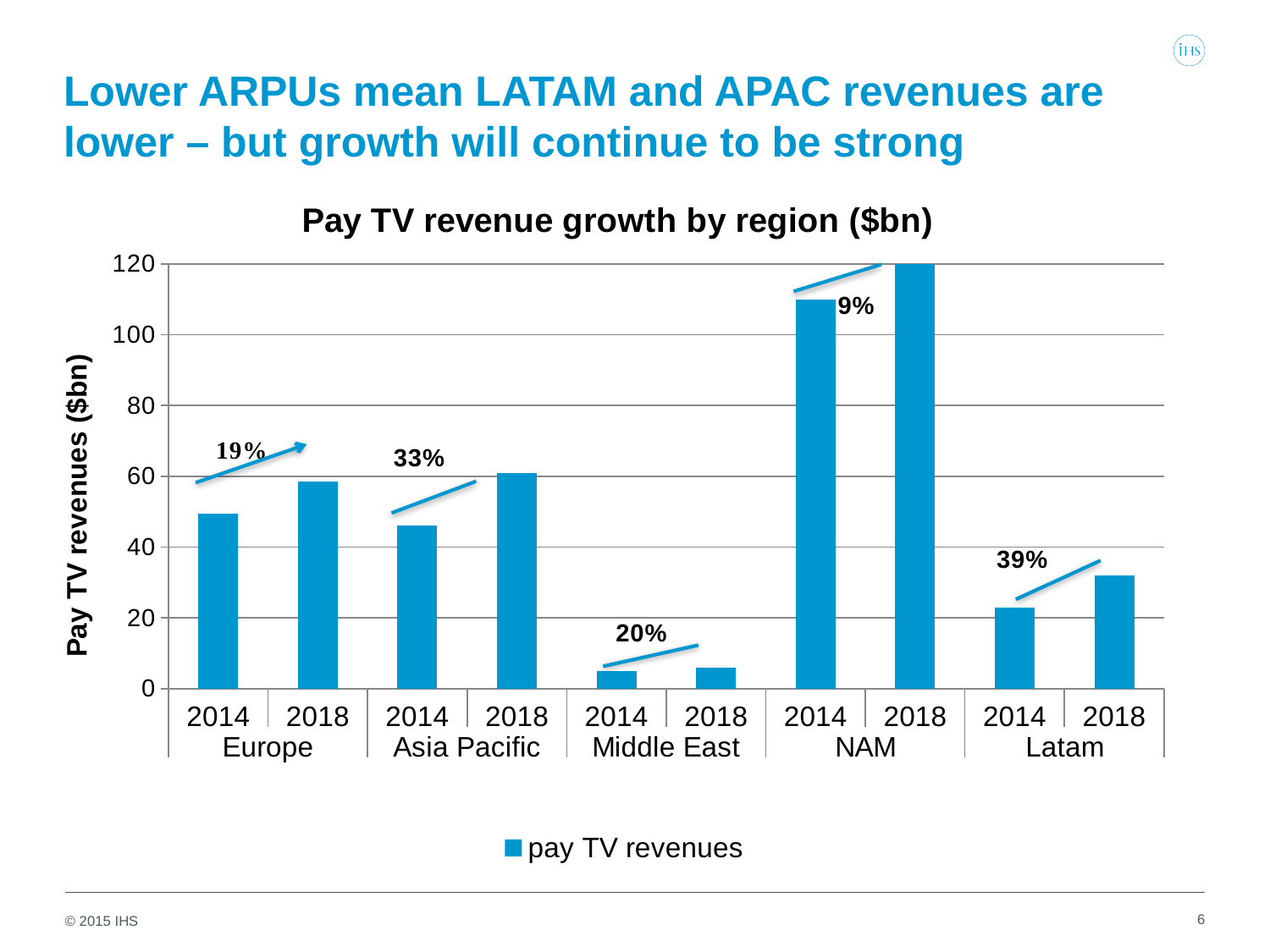
What is the title of the chart? Pay TV revenue growth by region ($bn) How many regions are shown on the x axis of the chart? 5 Is the value for Latam 2018 greater or less than 40? less Is the value for Europe 2014 greater or less than 40? greater Which region and year has the tallest bar? NAM 2018 Which is larger, the 2018 bar for Europe or the 2018 bar for Latam? Europe How many series does the legend list? 1 What kind of chart is shown on the slide? bar chart What growth percentage is annotated for NAM? 9% Which region and year has the shortest bar? Middle East 2014 What growth percentage is annotated for Latam? 39% Is the value for Middle East 2018 greater or less than 20? less